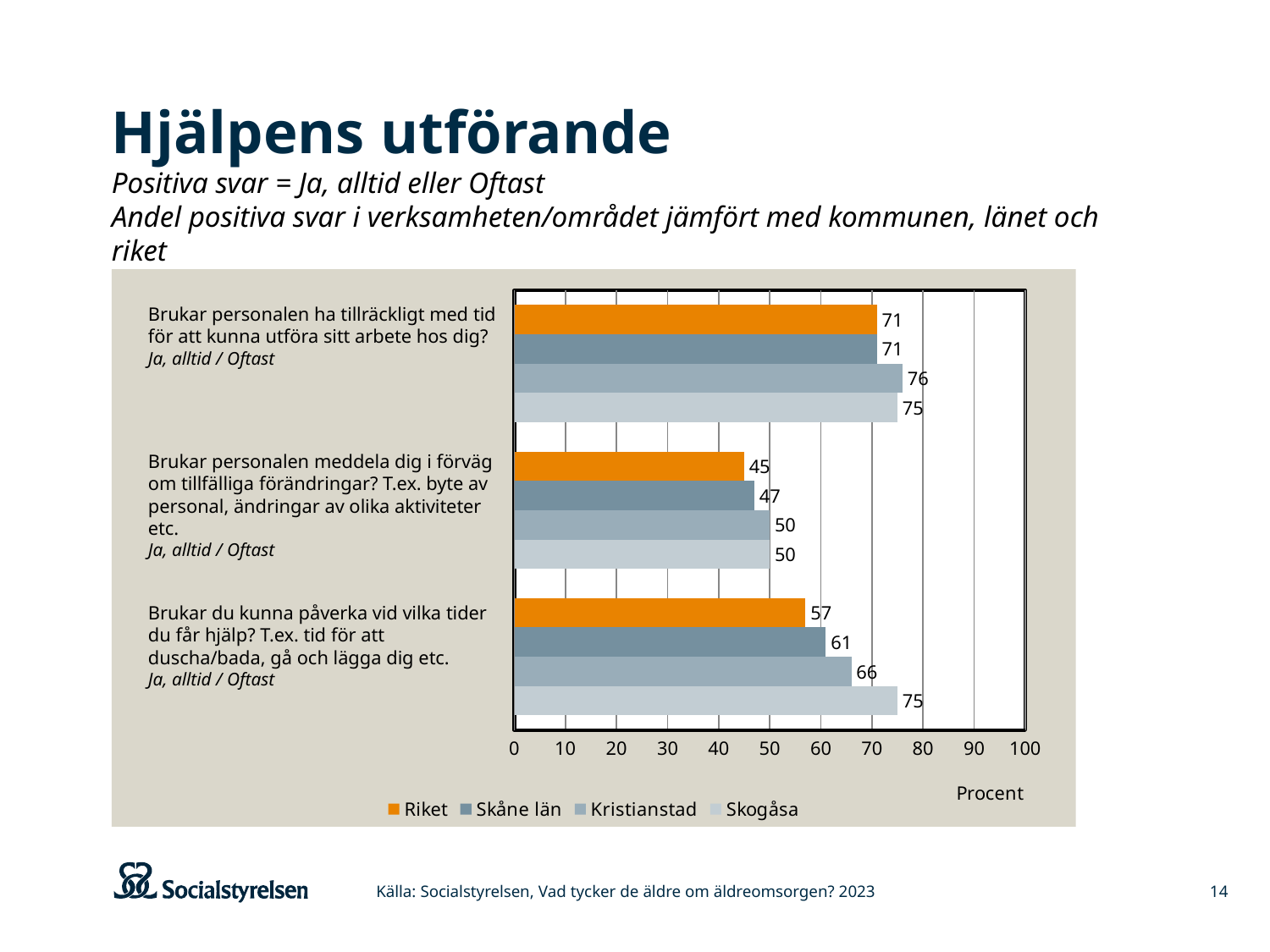
What unit label is shown below the x axis of the chart? Procent What is the value for Riket on the question "Brukar personalen meddela dig i förväg om tillfälliga förändringar?"? 45 Which series has the lowest value on the question "Brukar personalen meddela dig i förväg om tillfälliga förändringar?"? Riket Which is larger on the question "Brukar personalen ha tillräckligt med tid för att kunna utföra sitt arbete hos dig?": Kristianstad or Riket? Kristianstad Which series has the highest value on the question "Brukar du kunna påverka vid vilka tider du får hjälp?"? Skogåsa How many series does the legend list? 4 What kind of chart is shown on the slide? bar chart Is the value for Skåne län on the question "Brukar personalen meddela dig i förväg om tillfälliga förändringar?" greater or less than 50? less How many question categories are plotted on the chart? 3 What is the value for Kristianstad on the question "Brukar du kunna påverka vid vilka tider du får hjälp?"? 66 What is the value for Skogåsa on the question "Brukar personalen ha tillräckligt med tid för att kunna utföra sitt arbete hos dig?"? 75 What is the difference between Skogåsa and Riket on the question "Brukar du kunna påverka vid vilka tider du får hjälp?"? 18